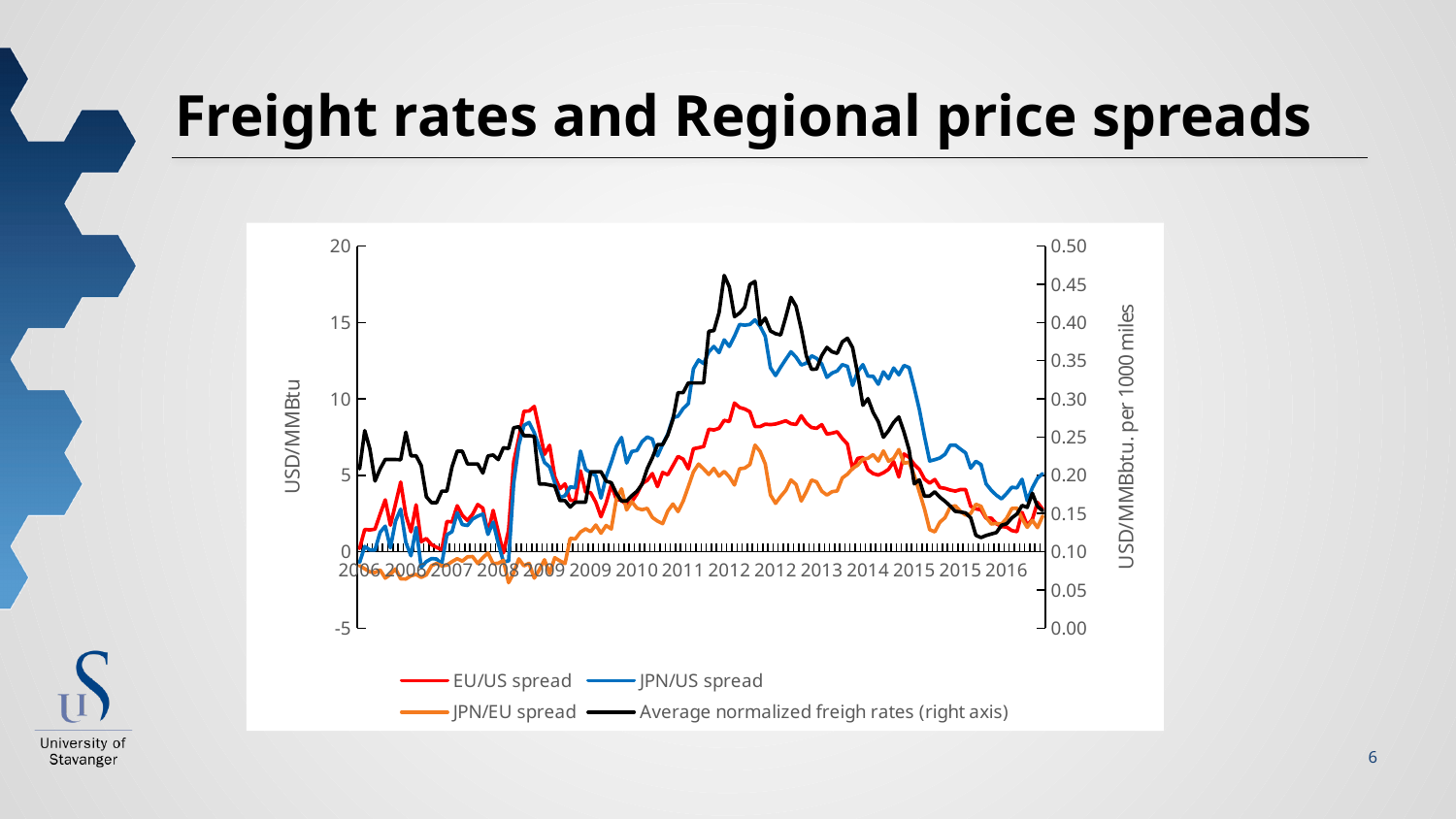
Which of the three spread series stays lowest over most of the period? JPN/EU spread What is the title of the slide's chart? Freight rates and Regional price spreads Does the JPN/US spread rise or fall between 2012 and 2016? fall Is the peak value of the EU/US spread greater or less than 15? less How many series does the legend list? 4 Is the peak value of the JPN/US spread greater or less than 10? greater Is the peak of the Average normalized freight rates series greater or less than 0.40 on the right axis? greater Around 2012, which is larger: the JPN/US spread or the EU/US spread? JPN/US spread Which series is plotted on the right axis according to the legend? Average normalized freigh rates Which of the three spread series reaches the highest value on the left axis? JPN/US spread What kind of chart is shown on the slide? line chart